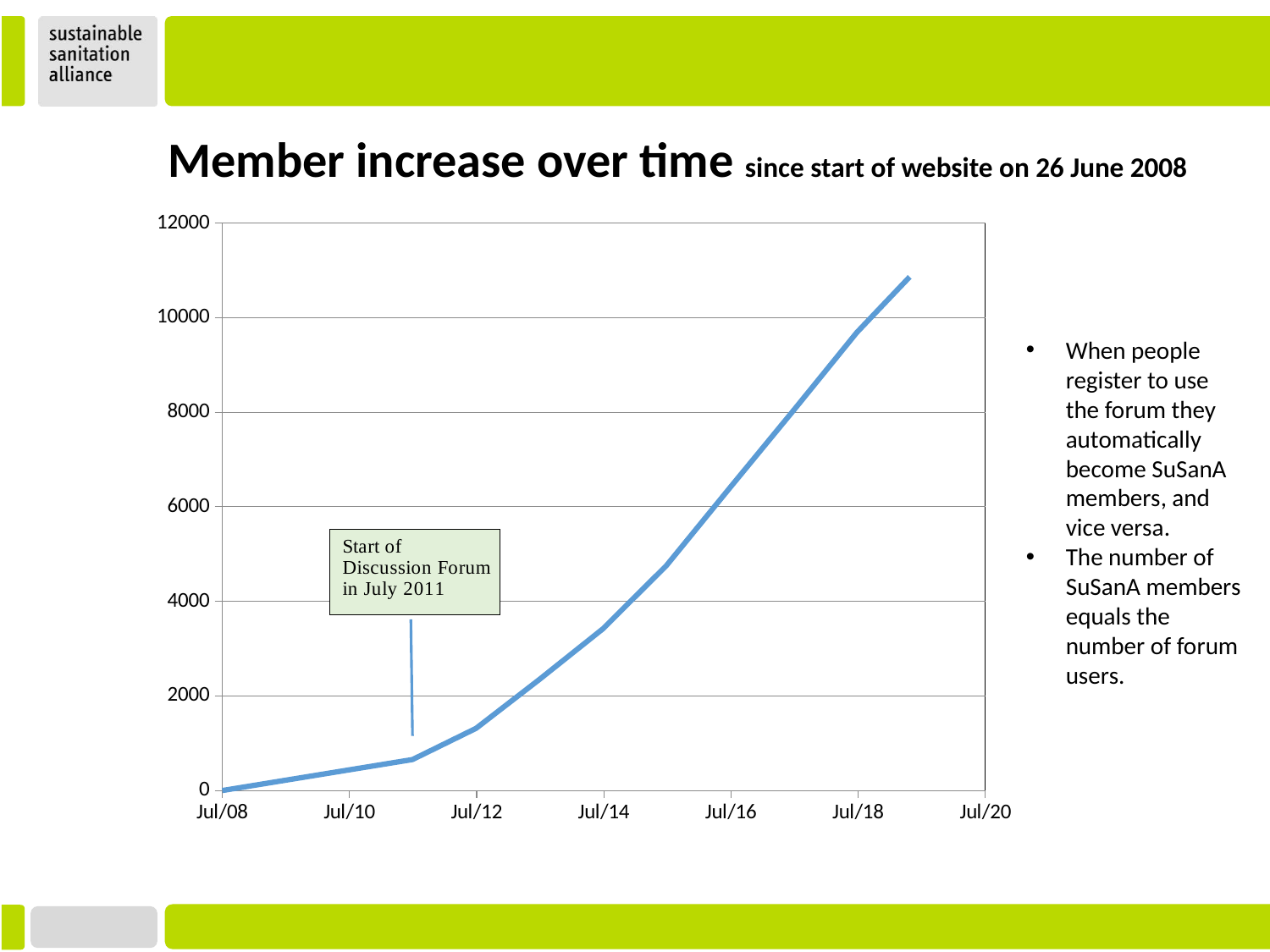
Is the value for Jul/14 greater or less than 4000? less What kind of chart is shown on the slide? line chart Is the last plotted value on the line greater or less than 12000? less How many tick labels are shown on the x axis? 7 What is the highest value shown on the y axis? 12000 Is the last plotted value on the line greater or less than 10000? greater What event does the annotation box on the chart mark? Start of Discussion Forum in July 2011 Do the member numbers rise or fall over time along the x axis? rise